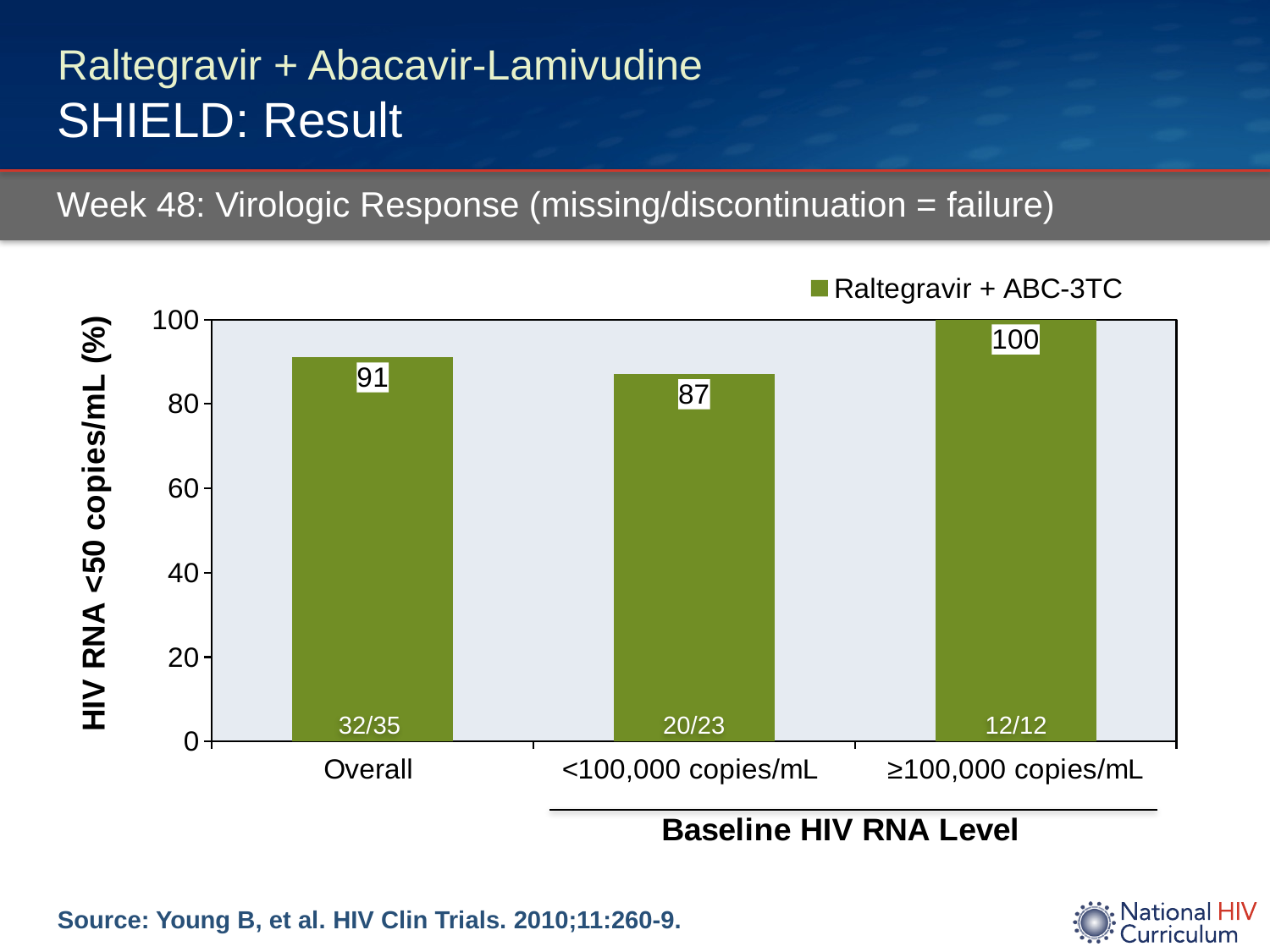
What is the value for ≥100,000 copies/mL? 100 How many categories are shown on the x axis? 3 What is the series name shown in the legend? Raltegravir + ABC-3TC What kind of chart is shown? bar chart What is the value for Overall? 91 What is the value for <100,000 copies/mL? 87 What is the difference between the values for Overall and <100,000 copies/mL? 4 Which is larger, the value for Overall or the value for <100,000 copies/mL? Overall How many series does the legend list? 1 Which category has the highest value? ≥100,000 copies/mL Which category has the lowest value? <100,000 copies/mL What is the difference between the values for ≥100,000 copies/mL and <100,000 copies/mL? 13